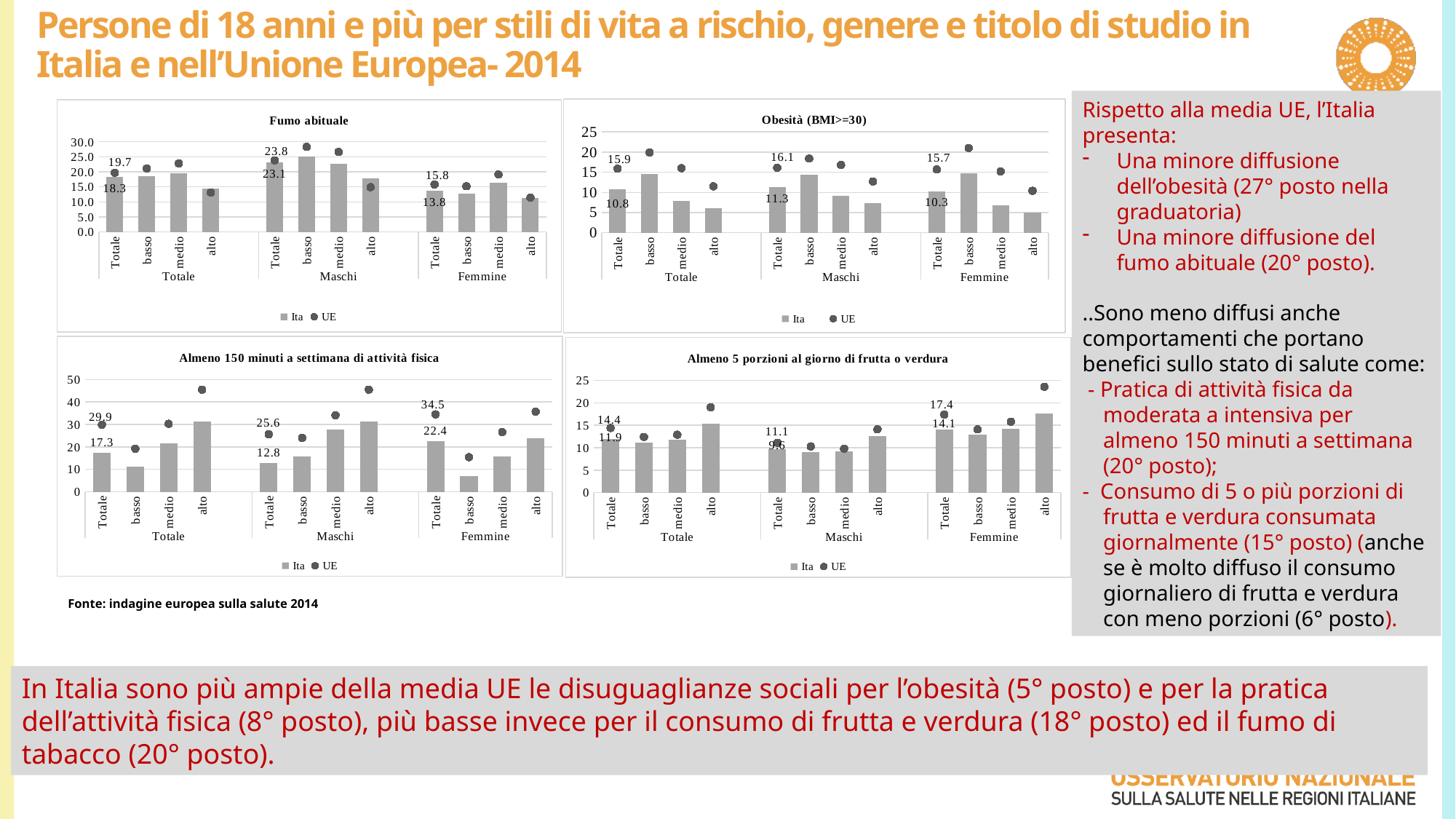
In the 'Almeno 150 minuti a settimana di attività fisica' chart, which is larger for Totale in the Femmine group, Ita or UE? UE How many series does the legend of the 'Obesità (BMI>=30)' chart list? 2 How many bars are plotted in the 'Fumo abituale' chart? 12 In the 'Almeno 150 minuti a settimana di attività fisica' chart, what is the Ita value for Totale in the Maschi group? 12.8 In the 'Obesità (BMI>=30)' chart, what is the UE value for Totale in the Femmine group? 15.7 In the 'Almeno 5 porzioni al giorno di frutta o verdura' chart, what is the Ita value for Totale in the Femmine group? 14.1 In the 'Obesità (BMI>=30)' chart, what is the difference between the UE and Ita values for Totale in the Totale group? 5.1 In the 'Almeno 5 porzioni al giorno di frutta o verdura' chart, what is the difference between the UE and Ita values for Totale in the Maschi group? 1.5 What kind of chart is the 'Fumo abituale' chart? Combination chart: bars for Ita and dot markers for UE In the 'Fumo abituale' chart, what is the UE value for Totale in the Maschi group? 23.8 In the 'Almeno 150 minuti a settimana di attività fisica' chart, is the Ita value for 'alto' in the Totale group greater or less than 20? greater In the 'Fumo abituale' chart, what is the Ita value for Totale (Totale group)? 18.3